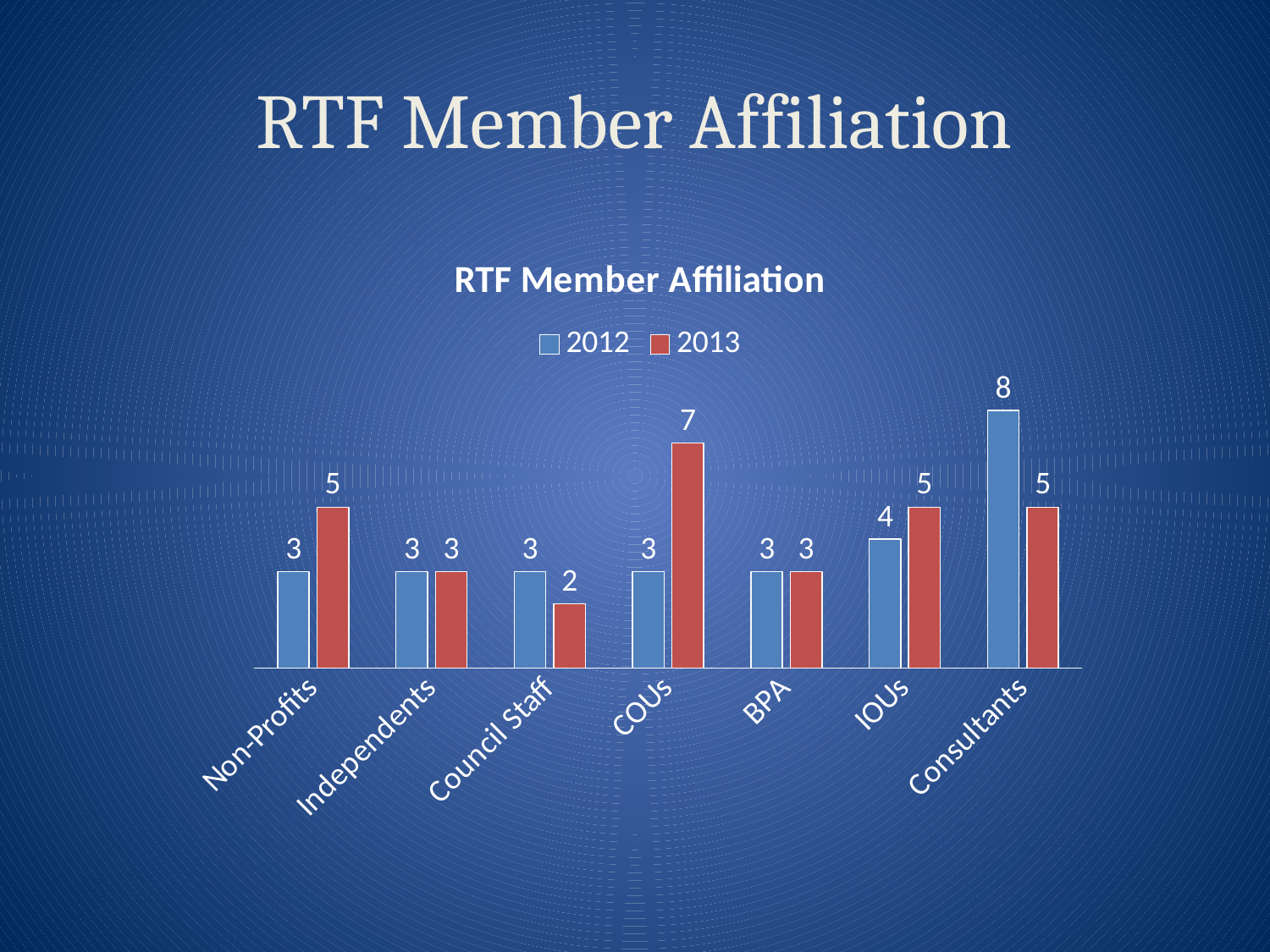
Which is larger for Consultants, the 2012 value or the 2013 value? 2012 What kind of chart is shown? Bar chart Which category has the highest 2012 value? Consultants How many series does the legend list? 2 Which category has the lowest 2013 value? Council Staff What is the 2013 value for COUs? 7 What is the 2012 value for Consultants? 8 What is the 2013 value for Council Staff? 2 How many categories are shown on the x axis? 7 What is the title of the chart? RTF Member Affiliation What is the 2012 value for IOUs? 4 What is the difference between the 2013 and 2012 values for COUs? 4